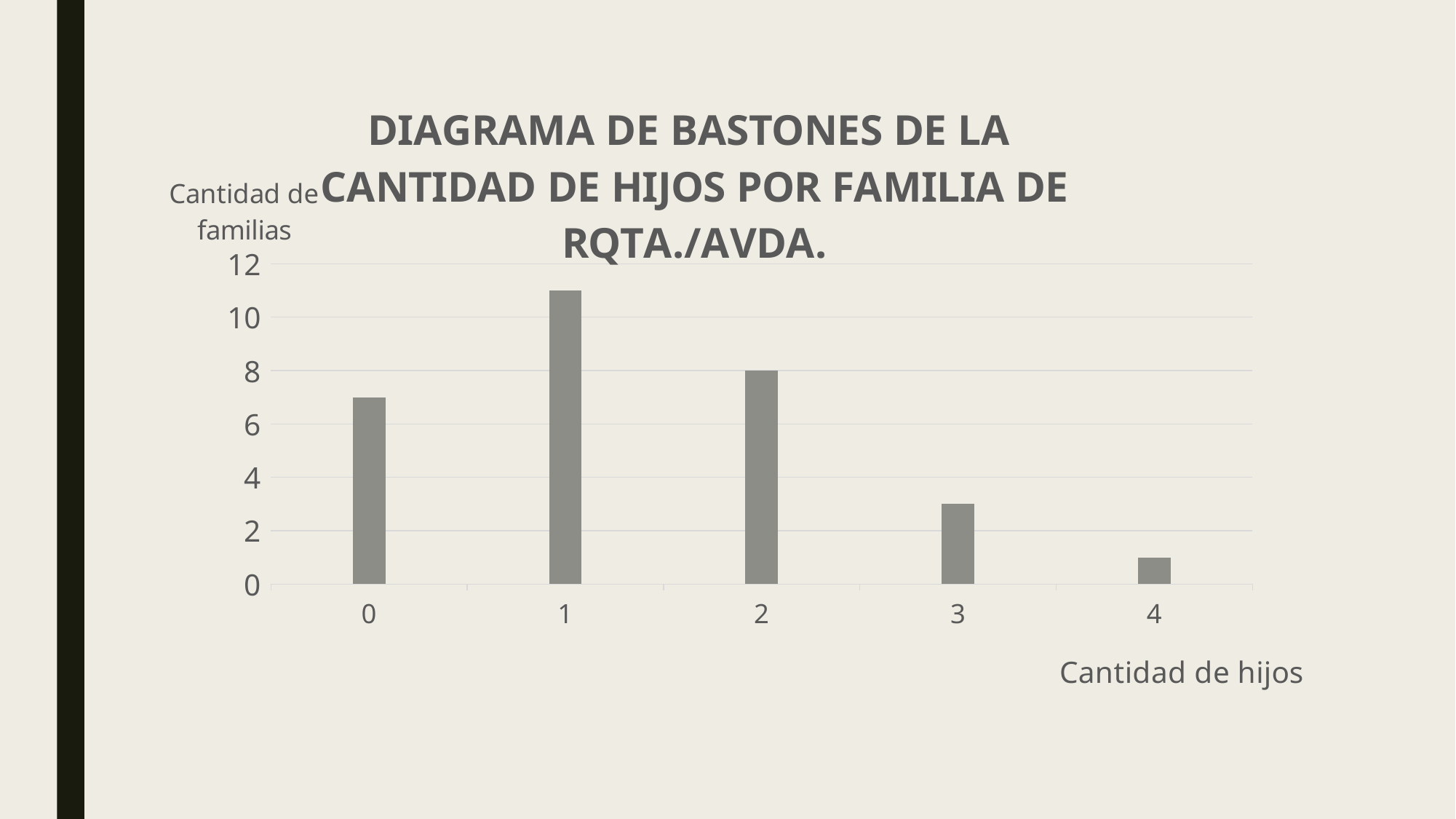
How many categories (values of Cantidad de hijos) are shown on the x axis? 5 Which has more families: category 1 or category 3? 1 What is the value (Cantidad de familias) for category 2? 8 Is the value for category 1 greater or less than 10? greater Is the value for category 0 greater or less than 8? less Is the value for category 4 greater or less than 2? less From category 1 to category 4, do the values rise or fall? fall Which category (Cantidad de hijos) has the highest number of families? 1 What is the label of the horizontal (x) axis? Cantidad de hijos Which category (Cantidad de hijos) has the lowest number of families? 4 What kind of chart is shown on the slide? bar chart